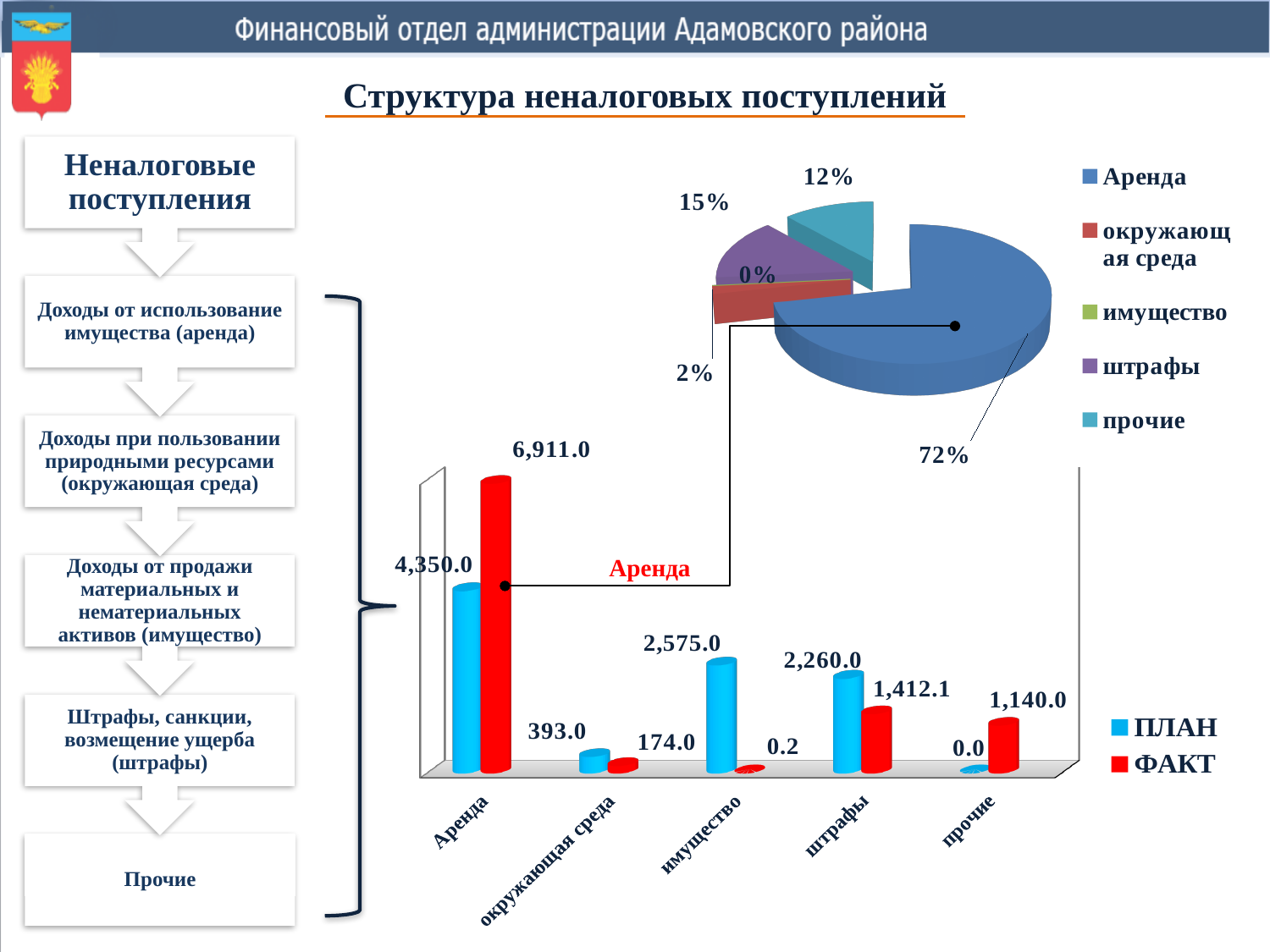
On the bar chart at the bottom of the slide, which category has the lowest ФАКТ value? имущество On the bar chart at the bottom of the slide, what is the ФАКТ value for штрафы? 1,412.1 On the pie chart in the top right of the slide, what share does Аренда have? 72% On the bar chart at the bottom of the slide, which category has the highest ПЛАН value? Аренда On the pie chart in the top right of the slide, what share does штрафы have? 15% What kind of chart is shown in the top right of the slide? Pie chart On the bar chart at the bottom of the slide, which is larger for окружающая среда: ПЛАН or ФАКТ? ПЛАН On the bar chart at the bottom of the slide, what is the ФАКТ value for Аренда? 6,911.0 On the bar chart at the bottom of the slide, what is the ПЛАН value for имущество? 2,575.0 On the bar chart at the bottom of the slide, how many categories are shown on the x axis? 5 On the bar chart at the bottom of the slide, what is the difference between the ФАКТ and ПЛАН values for Аренда? 2,561.0 On the bar chart at the bottom of the slide, how many series does the legend list? 2